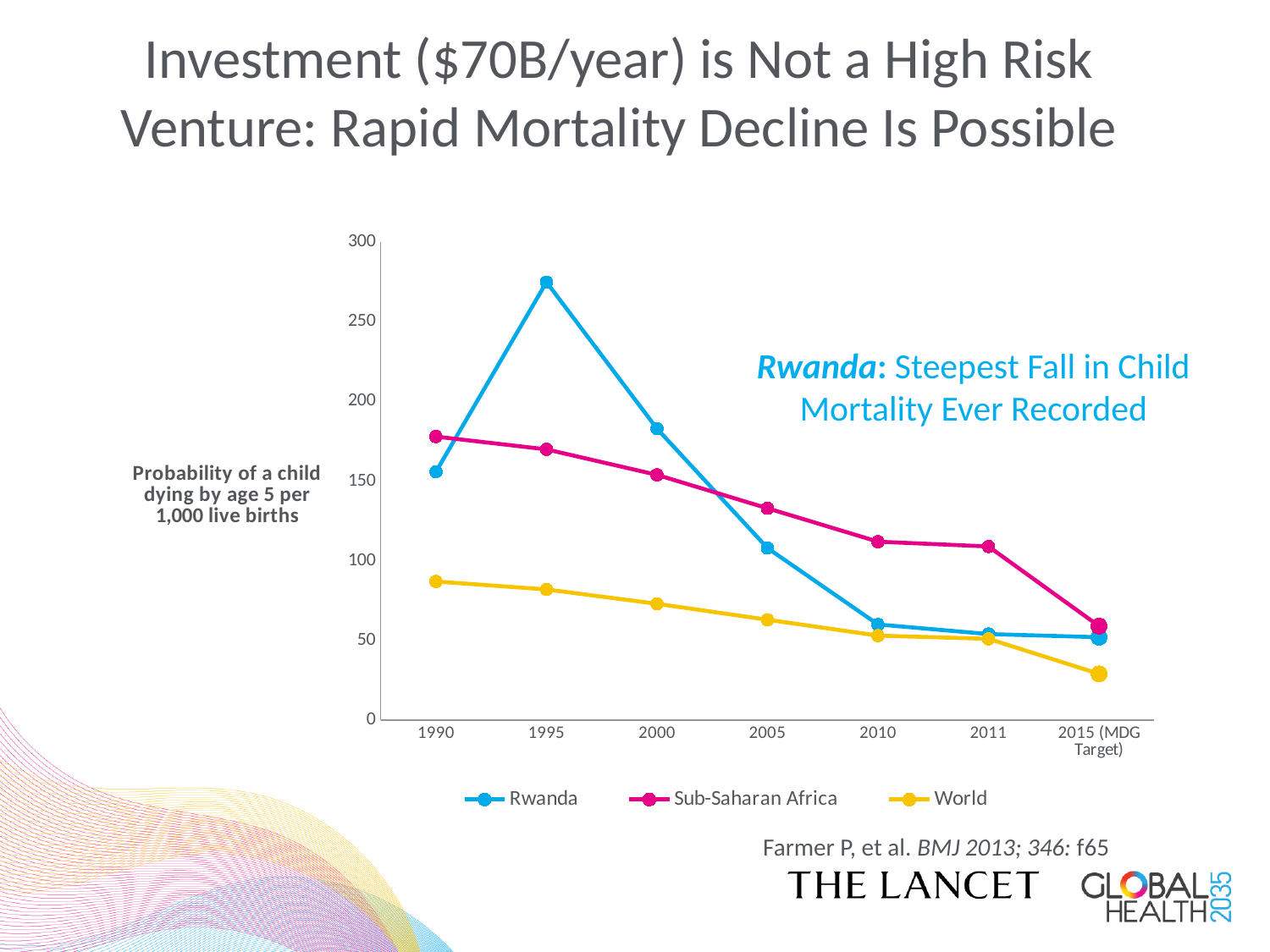
Is the value for Sub-Saharan Africa in 2015 (MDG Target) greater or less than 100? less Is the value for Rwanda in 2000 greater or less than 150? greater How many series does the legend list? 3 In 2005, which is higher: Rwanda or Sub-Saharan Africa? Sub-Saharan Africa What is the label on the y axis of the chart? Probability of a child dying by age 5 per 1,000 live births Does the World series rise or fall from 1990 to 2015 (MDG Target)? Fall How many points are shown along the x axis? 7 Is the value for World in 1990 greater or less than 100? less In 1990, which is higher: Rwanda or Sub-Saharan Africa? Sub-Saharan Africa In which year does the Rwanda series reach its highest value? 1995 What kind of chart is shown on the slide? Line chart